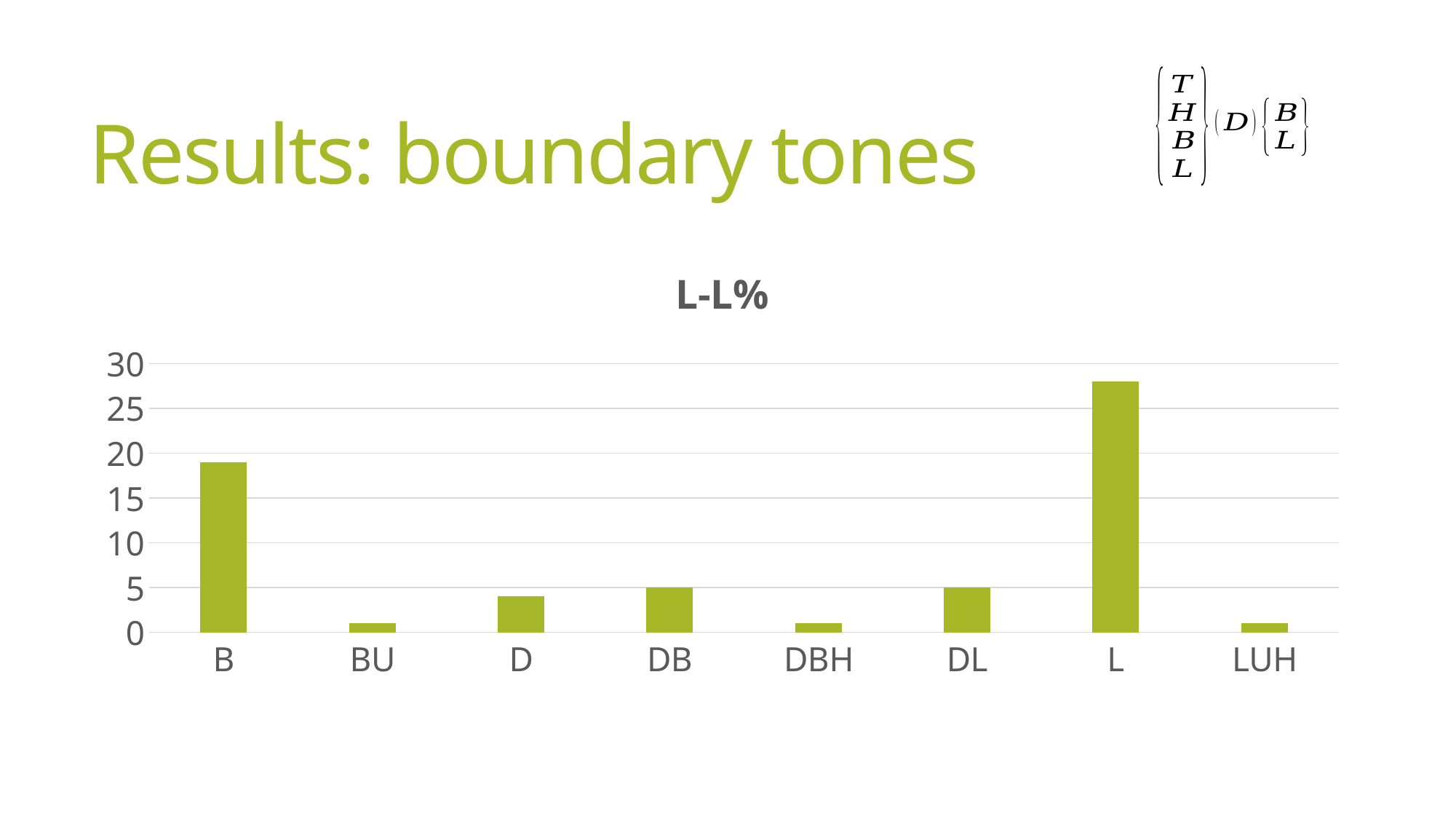
What is the value for DB in the chart? 5 Which is larger, the value for B or the value for DL? B Is the value for B greater or less than 20? less Is the value for L greater or less than 25? greater What is the title of the chart? L-L% Is the value for B greater or less than 15? greater Which is larger, the value for B or the value for L? L Which category has the highest value in the chart? L What kind of chart is shown on the slide? bar chart How many categories are shown on the x axis of the chart? 8